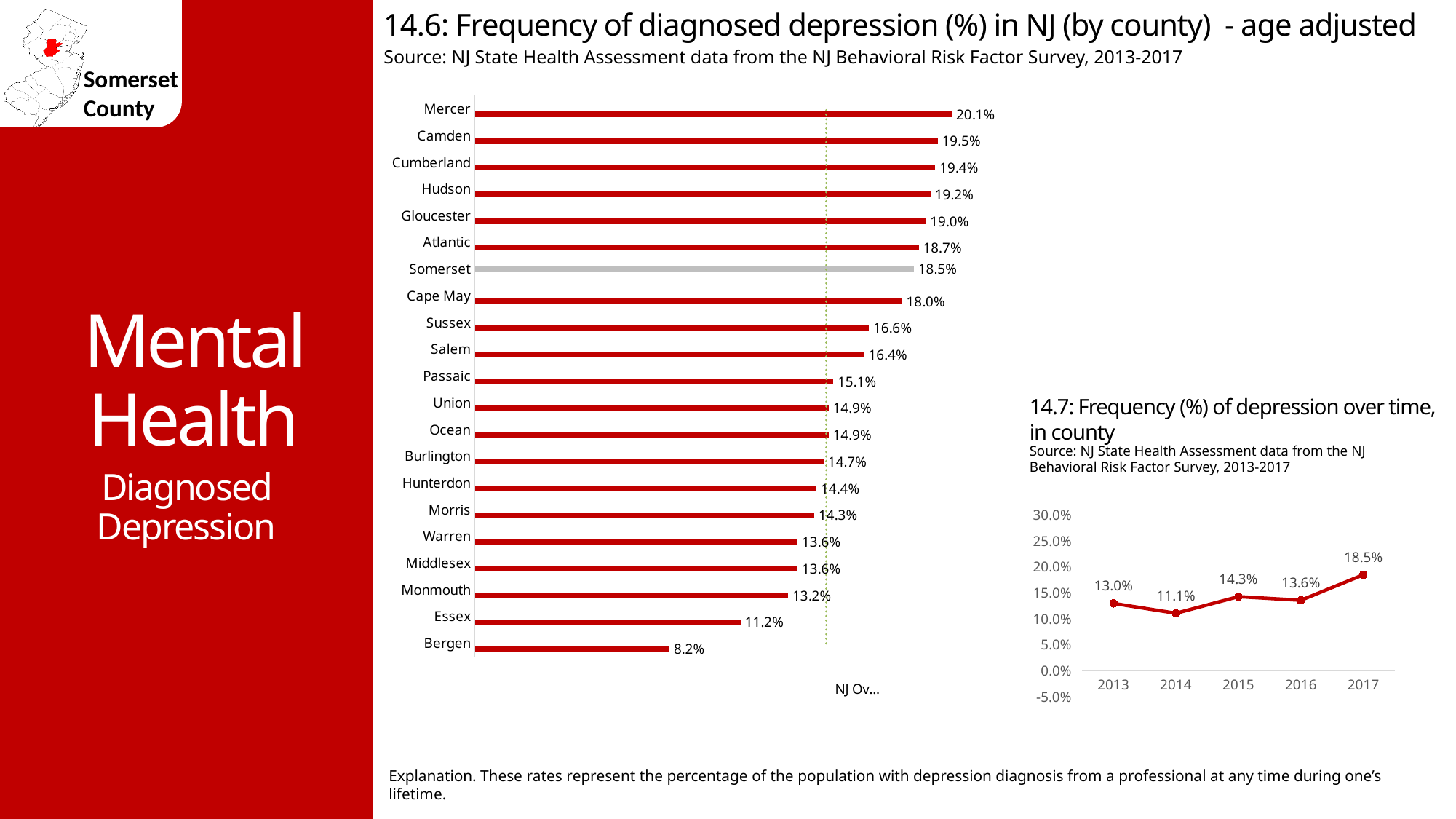
In the chart '14.6: Frequency of diagnosed depression (%) in NJ (by county) - age adjusted', how many counties are shown? 21 In the chart '14.7: Frequency (%) of depression over time, in county', what is the difference between 2017 and 2016? 4.9% In the chart '14.6: Frequency of diagnosed depression (%) in NJ (by county) - age adjusted', which county has the lowest value? Bergen In the chart '14.6: Frequency of diagnosed depression (%) in NJ (by county) - age adjusted', which is larger, Sussex or Salem? Sussex What kind of chart is '14.6: Frequency of diagnosed depression (%) in NJ (by county) - age adjusted'? Bar chart In the chart '14.6: Frequency of diagnosed depression (%) in NJ (by county) - age adjusted', what is the difference between Mercer and Bergen? 11.9% In the chart '14.7: Frequency (%) of depression over time, in county', what is the value for 2014? 11.1% In the chart '14.6: Frequency of diagnosed depression (%) in NJ (by county) - age adjusted', what is the value for Essex? 11.2% In the chart '14.6: Frequency of diagnosed depression (%) in NJ (by county) - age adjusted', what is the value for Somerset? 18.5% What kind of chart is '14.7: Frequency (%) of depression over time, in county'? Line chart In the chart '14.6: Frequency of diagnosed depression (%) in NJ (by county) - age adjusted', which county has the highest value? Mercer In the chart '14.7: Frequency (%) of depression over time, in county', which year has the highest value? 2017